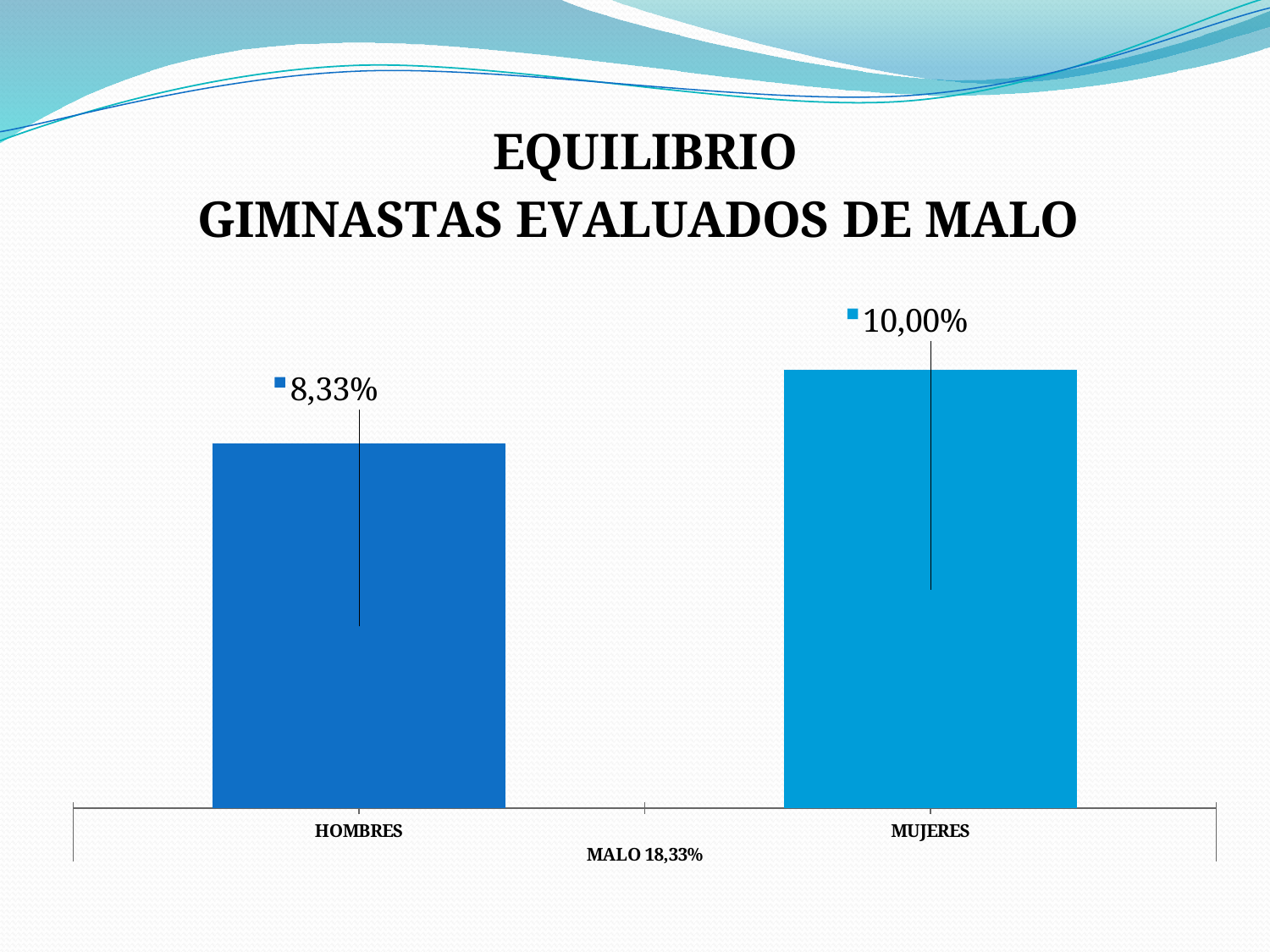
Which is larger, the value for HOMBRES or the value for MUJERES? MUJERES Which category has the highest value? MUJERES Which category has the lowest value? HOMBRES How many categories are shown in the chart? 2 What is the value for MUJERES? 10,00% What is the difference between the values for MUJERES and HOMBRES? 1,67% What is the value for HOMBRES? 8,33% What is the title of the chart? EQUILIBRIO GIMNASTAS EVALUADOS DE MALO What is the total of the two values shown in the chart? 18,33% What label appears below the category axis? MALO 18,33% What kind of chart is shown on the slide? bar chart